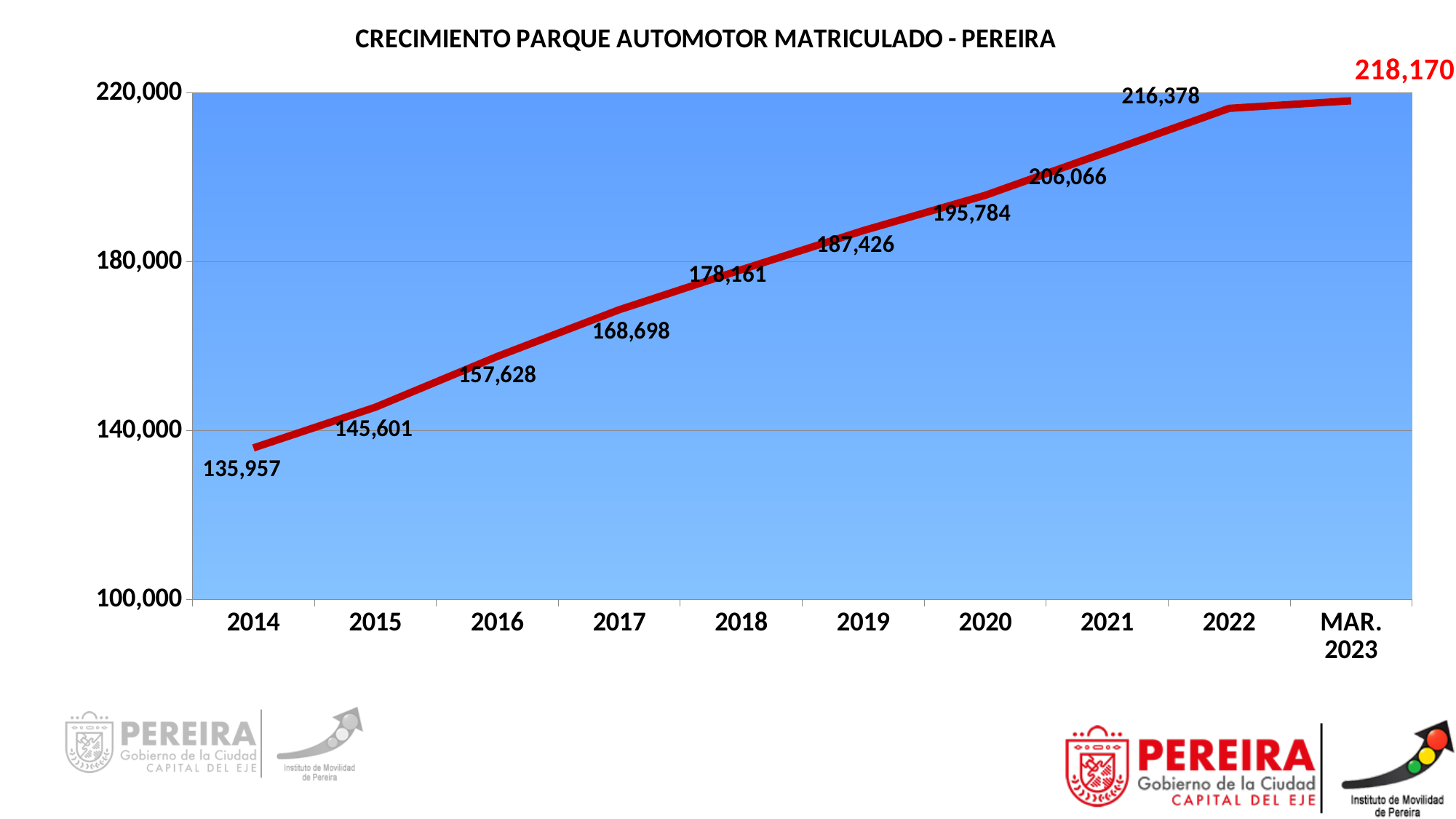
What is the difference between the values for 2015 and 2014? 9,644 What is the value for 2018? 178,161 What kind of chart is shown? line chart What is the value for MAR. 2023? 218,170 What is the difference between the values for 2022 and 2021? 10,312 How many points are plotted on the line? 10 What is the value for 2014? 135,957 Do the values rise or fall from 2014 to MAR. 2023? rise Which point on the x axis has the highest value? MAR. 2023 Is the value for 2017 greater or less than 180,000? less Which is larger, the value for 2019 or the value for 2020? 2020 Which year has the lowest value? 2014